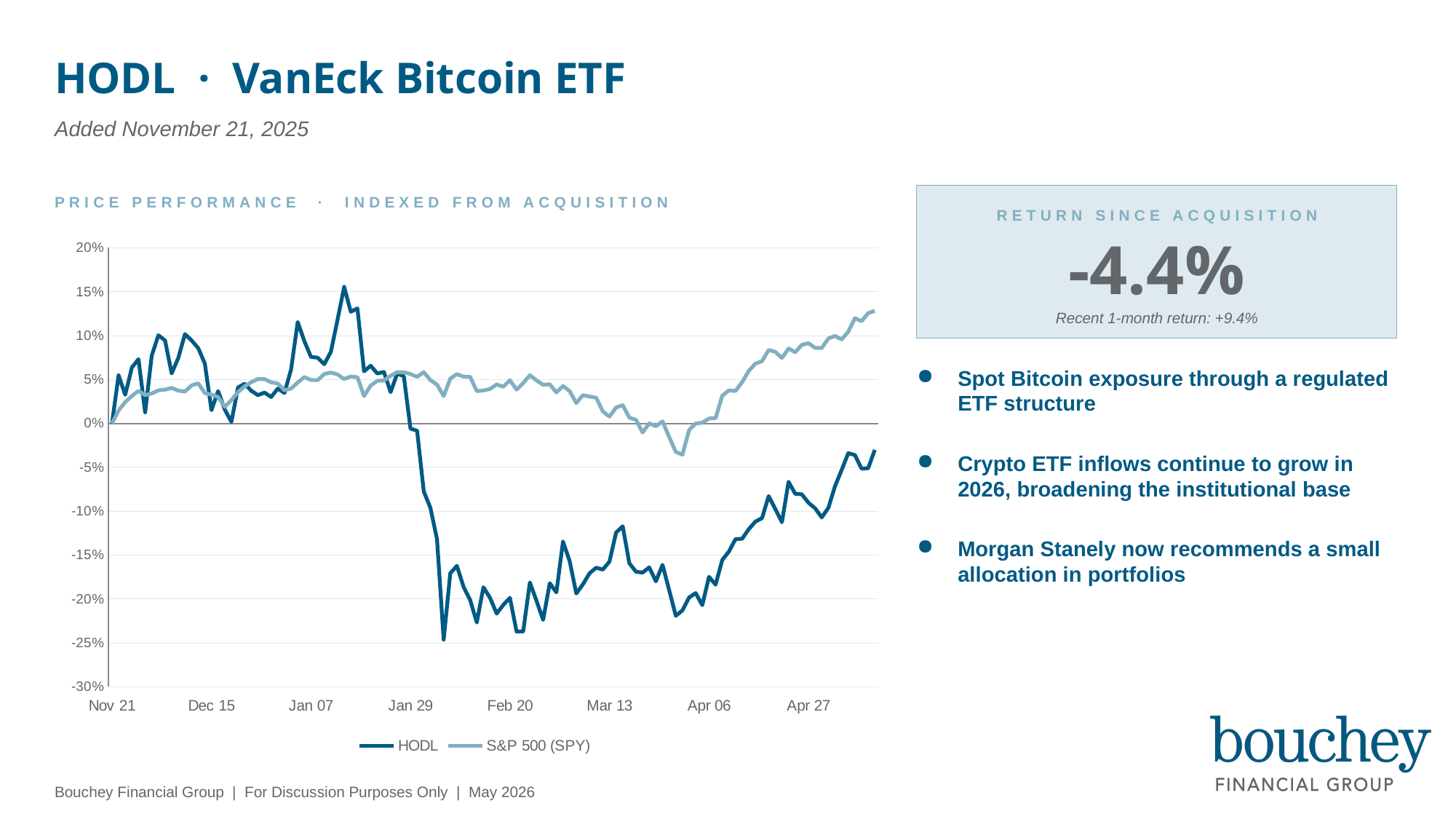
What is the title of the chart? PRICE PERFORMANCE · INDEXED FROM ACQUISITION How many series does the chart legend list? 2 Does the S&P 500 (SPY) line rise or fall between Apr 06 and the end of the chart? rise What kind of chart is shown on the slide? line chart Does the HODL line rise or fall between Jan 29 and Feb 20? fall Which series is higher at the right end of the chart, HODL or S&P 500 (SPY)? S&P 500 (SPY) Is the value for S&P 500 (SPY) at the right end of the chart greater or less than 10%? greater What is the return since acquisition shown for HODL? -4.4% Is the lowest point of the HODL line greater or less than -20%? less Which two series are listed in the chart legend? HODL and S&P 500 (SPY) Is the highest point of the HODL line greater or less than 10%? greater